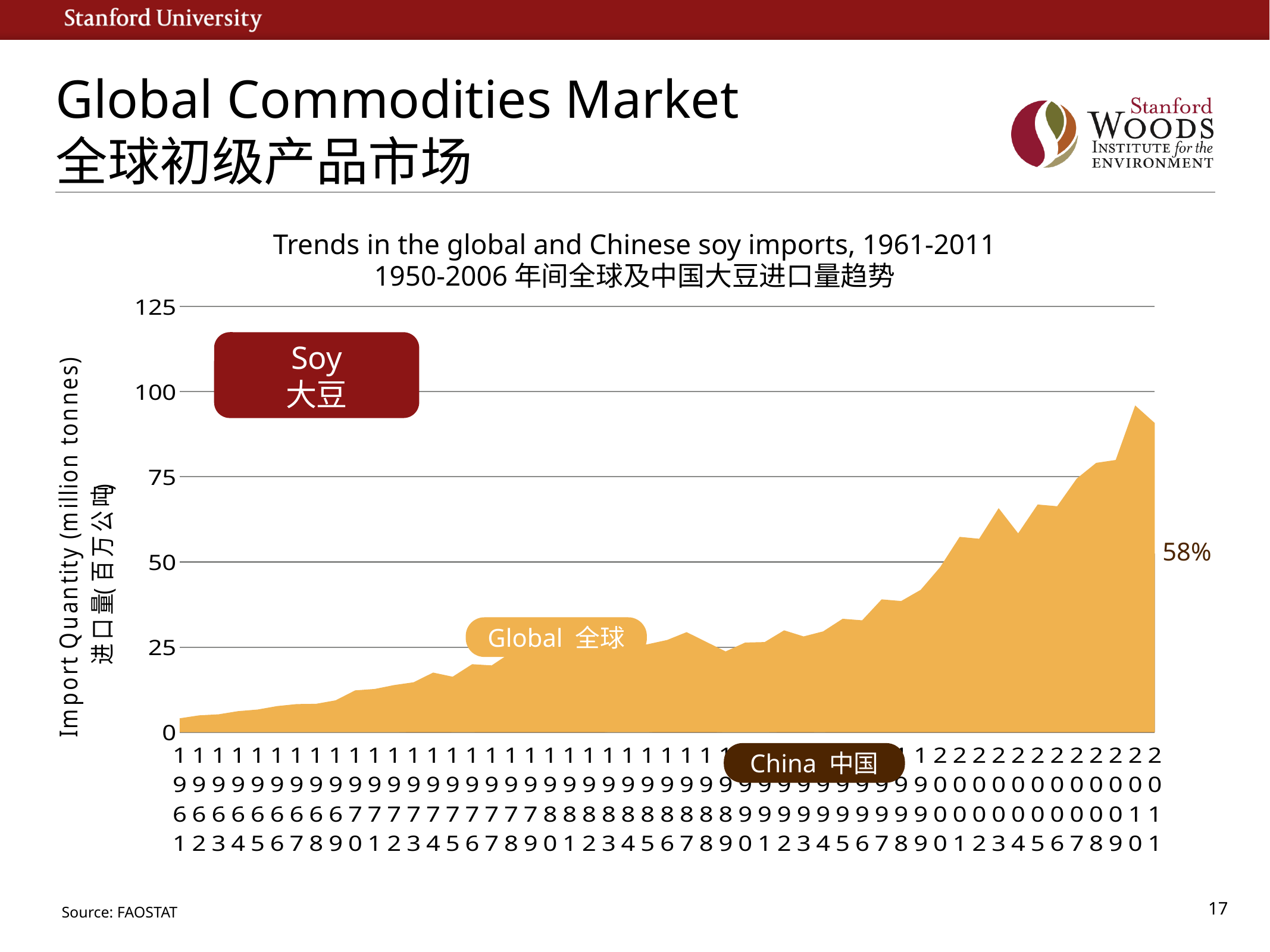
Which year has the lowest global soy import value? 1961 What kind of chart is shown on the slide? Area chart Which year has the highest global soy import value? 2010 Is the global soy import value for 1961 greater or less than 25? less Which year has the larger global soy import value, 1990 or 2005? 2005 Do global soy imports generally rise or fall from 1961 to 2011? Rise What is the title of the chart? Trends in the global and Chinese soy imports, 1961-2011 Is the global soy import value for 2011 greater or less than 75? greater Is the global soy import value for 1980 greater or less than 50? less What is the label on the vertical axis of the chart? Import Quantity (million tonnes) What percentage is annotated at the right edge of the chart? 58%